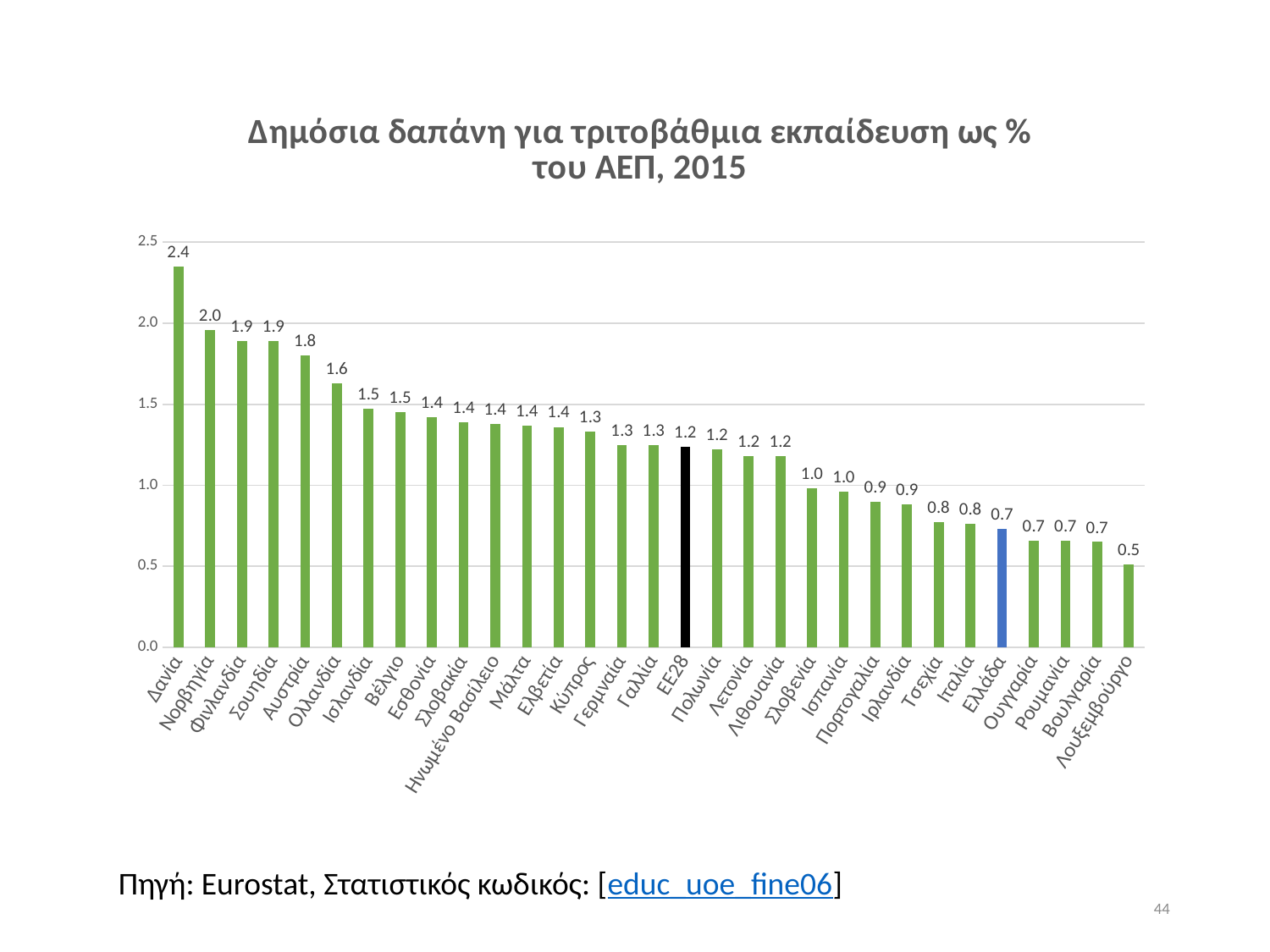
What is the difference between the values for Δανία and Λουξεμβούργο? 1.9 What is the value for ΕΕ28? 1.2 Which has a larger value, Νορβηγία or Αυστρία? Νορβηγία What colour is the bar for Ελλάδα? Blue Which country has the lowest value? Λουξεμβούργο Which country has the highest value? Δανία What kind of chart is this? Bar chart What is the difference between the values for Δανία and Ελλάδα? 1.7 How many countries/categories are shown on the x axis? 31 Do the values rise or fall from left to right along the x axis? Fall What is the value for Δανία? 2.4 What is the value for Ελλάδα? 0.7